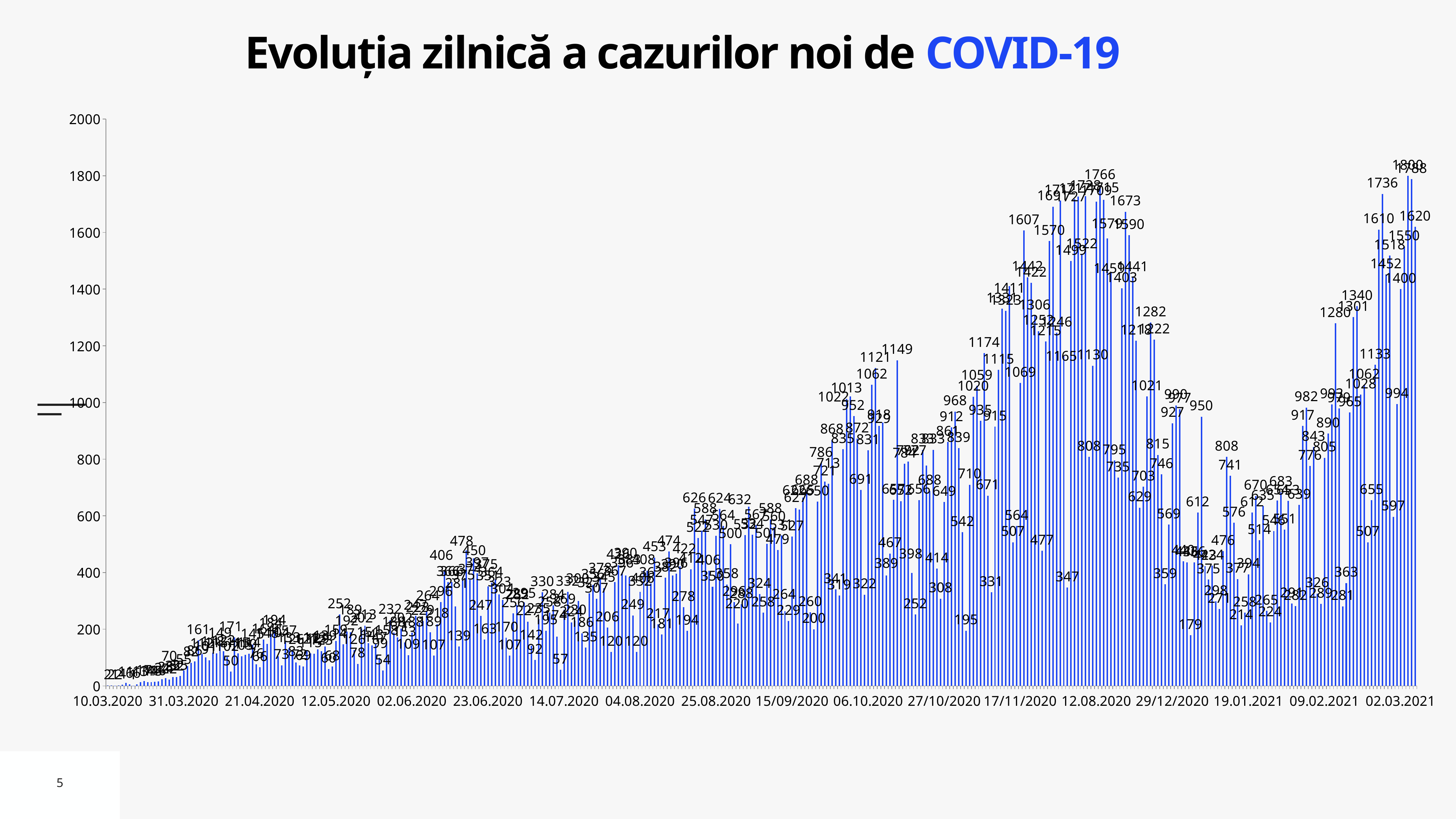
What is the highest value labelled in the peak between the 02.06.2020 and 23.06.2020 axis labels? 478 What is the title of the chart? Evoluția zilnică a cazurilor noi de COVID-19 What kind of chart is shown on the slide? bar chart What is the highest value labelled on the chart? 1800 Is the value for the first bar at 10.03.2020 greater or less than 200? less What is the highest value labelled in the peak between the 17/11/2020 and 12.08.2020 axis labels? 1766 Which is larger, the labelled value 1736 or the labelled value 1610? 1736 What is the maximum value shown on the vertical axis? 2000 How many date labels are shown along the x axis? 18 Is the value for the last bar at 02.03.2021 greater or less than 1000? greater What is the difference between the labelled values 1766 and 478? 1288 Do the values generally rise or fall from 10.03.2020 to 02.03.2021? rise